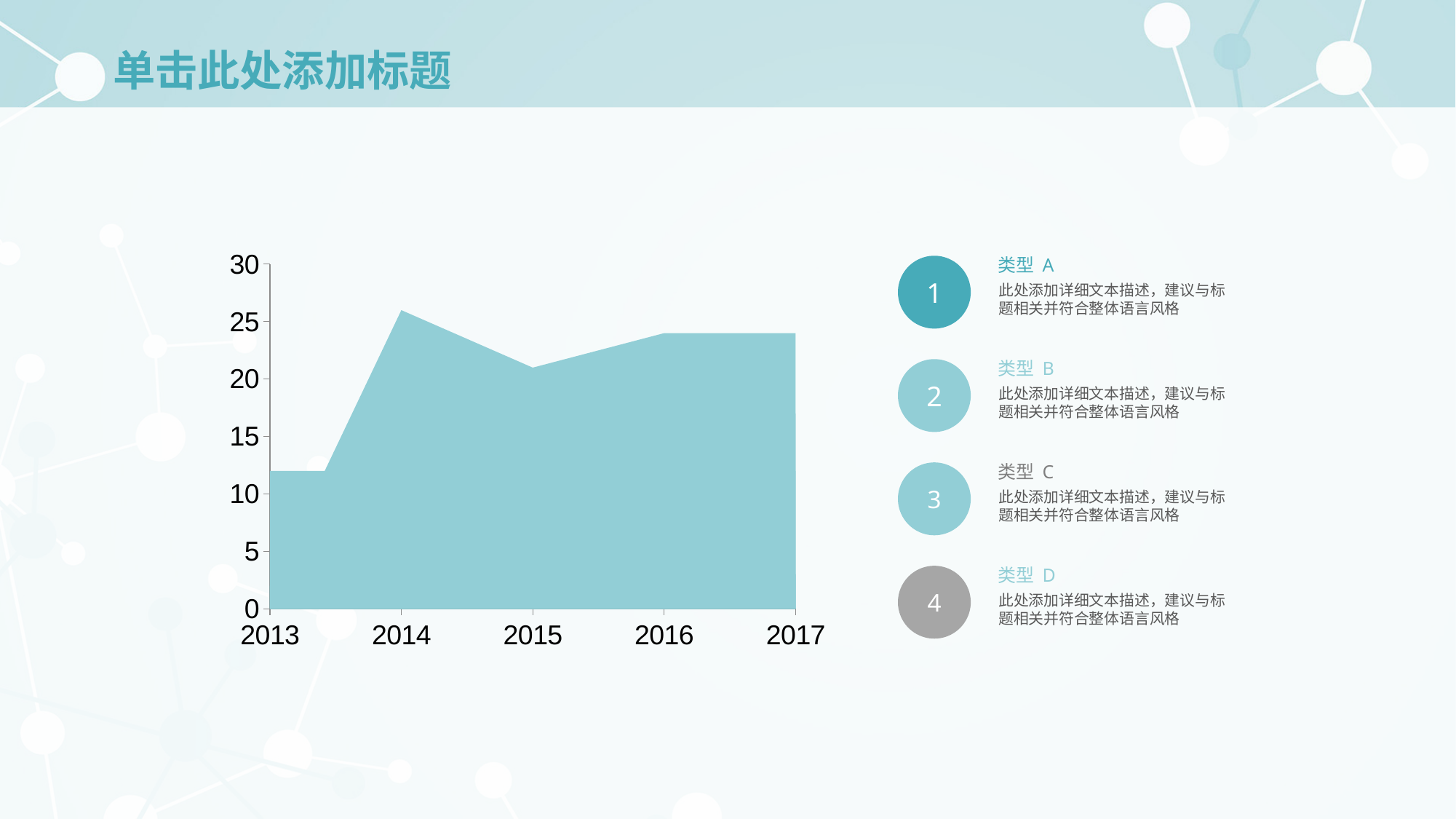
Is the value for 2013 greater or less than 15? less Does the value rise or fall from 2014 to 2015? fall Is the value for 2017 greater or less than 20? greater How many years are shown on the x axis of the chart? 5 What kind of chart is shown on the slide? area chart Is the value for 2014 greater or less than 25? greater Does the value rise or fall from 2013 to 2014? rise Which is larger, the value for 2014 or the value for 2015? 2014 Which year has the highest value in the chart? 2014 Which year has the lowest value in the chart? 2013